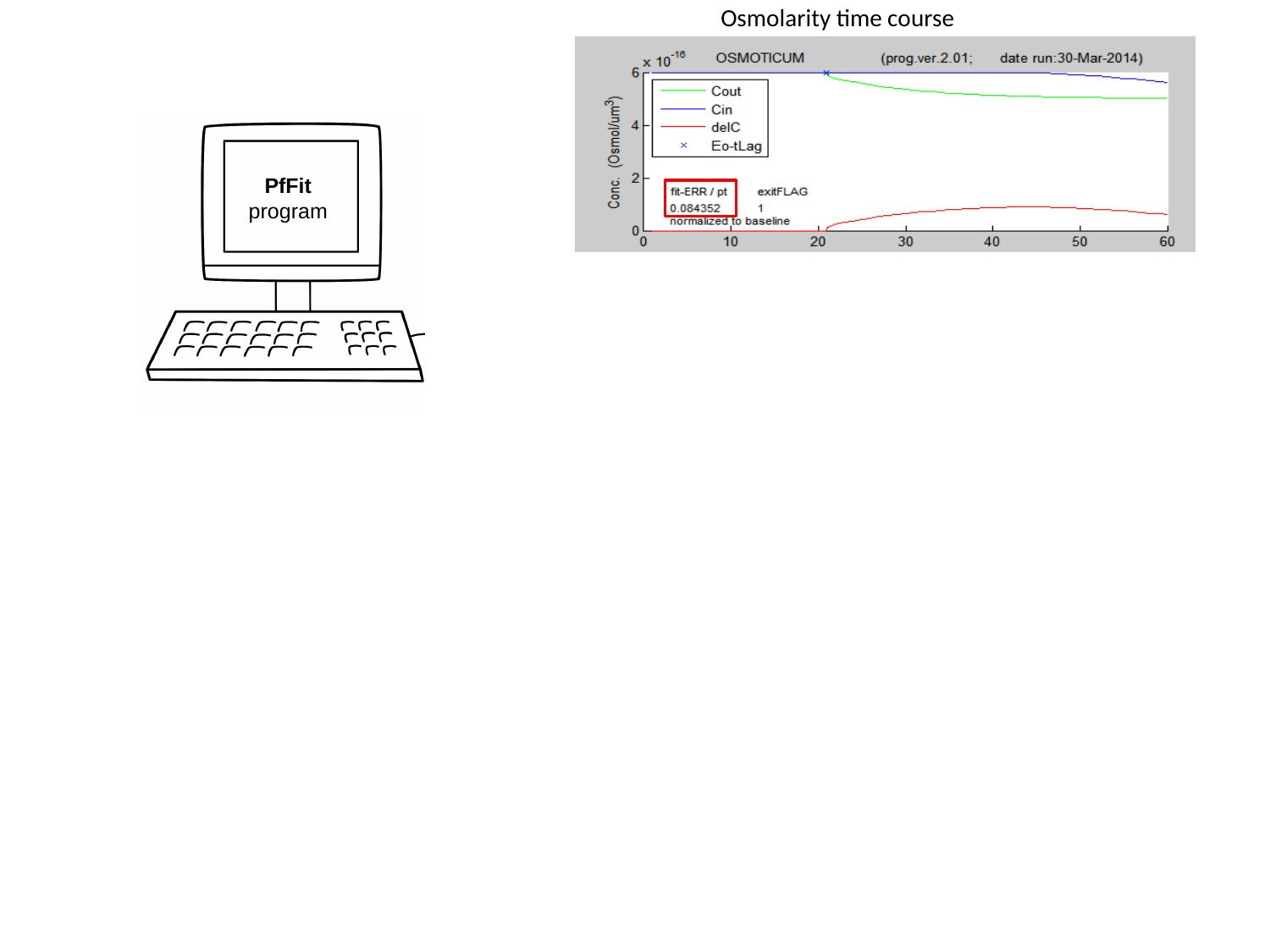
What title is printed at the top of the plot in the Osmolarity time course chart? OSMOTICUM In the Osmolarity time course chart, which series has the lowest value at x = 60? delC In the Osmolarity time course chart, is the value of delC at x = 60 greater or less than 2? less How many series does the legend of the Osmolarity time course chart list? 4 In the Osmolarity time course chart, is the value of Cout at x = 60 greater or less than 4? greater What kind of chart is shown under the heading 'Osmolarity time course'? line chart What fit-ERR / pt value is printed in the red box on the Osmolarity time course chart? 0.084352 In the Osmolarity time course chart, which series has the higher value at x = 60, Cin or Cout? Cin In the Osmolarity time course chart, does the Cout series rise or fall as x increases from 20 to 60? fall How many labelled tick marks are on the x axis of the Osmolarity time course chart? 7 In the Osmolarity time course chart, is the value of Cin at x = 60 greater or less than 4? greater In the Osmolarity time course chart, does the delC series rise or fall between x = 20 and x = 40? rise